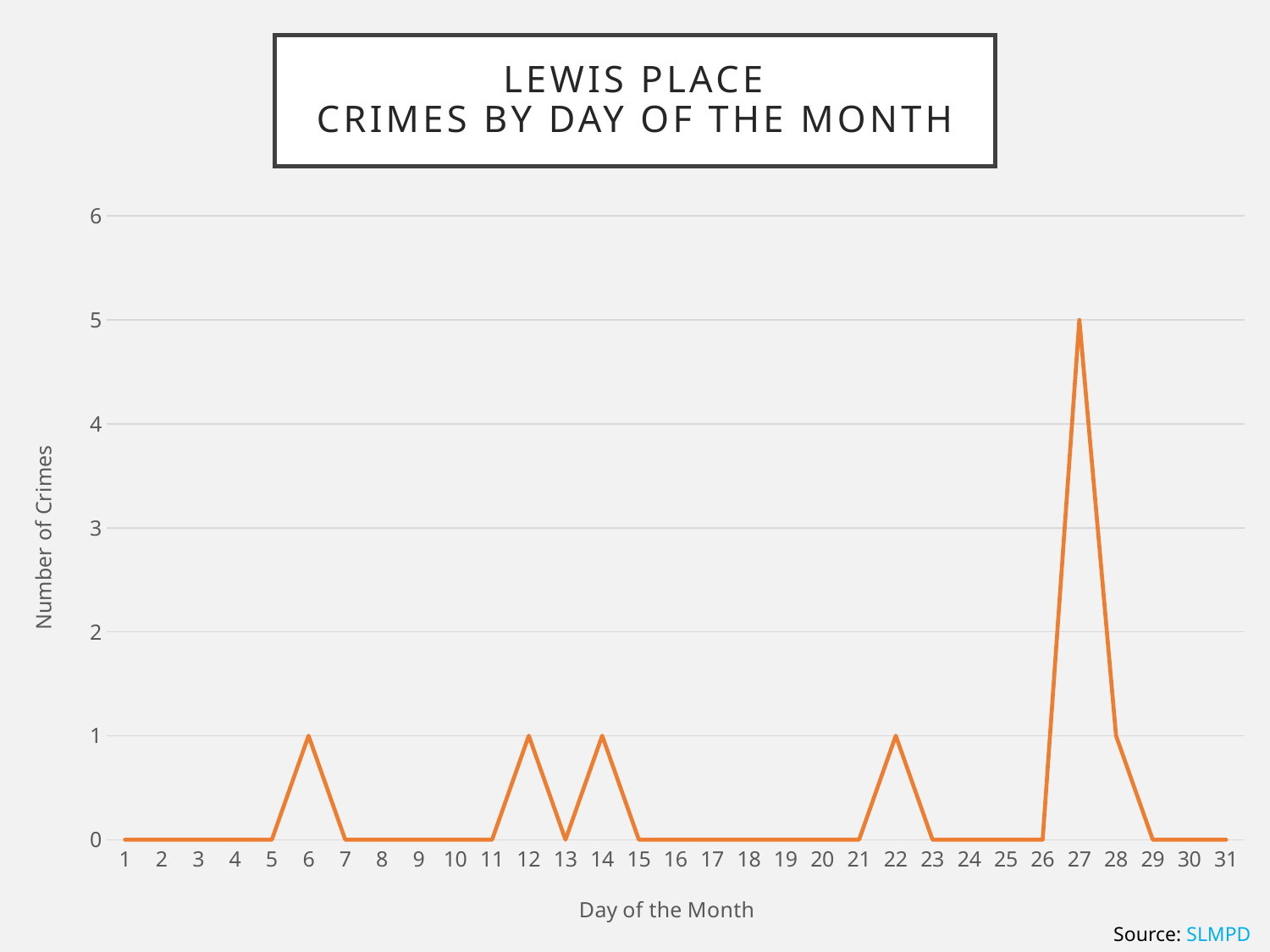
Which has more crimes, day 22 or day 27? Day 27 Is the value for day 27 greater or less than 4? greater How many crimes are recorded on day 27? 5 What is the title of the chart? Lewis Place Crimes by Day of the Month What is the difference in the number of crimes between day 27 and day 28? 4 How many crimes are recorded on day 6? 1 How many days of the month are shown on the x axis? 31 Which day of the month has the highest number of crimes? 27 What kind of chart is shown on the slide? Line chart What is the label of the y axis? Number of Crimes How many crimes are recorded on day 28? 1 How many crimes are recorded on day 20? 0